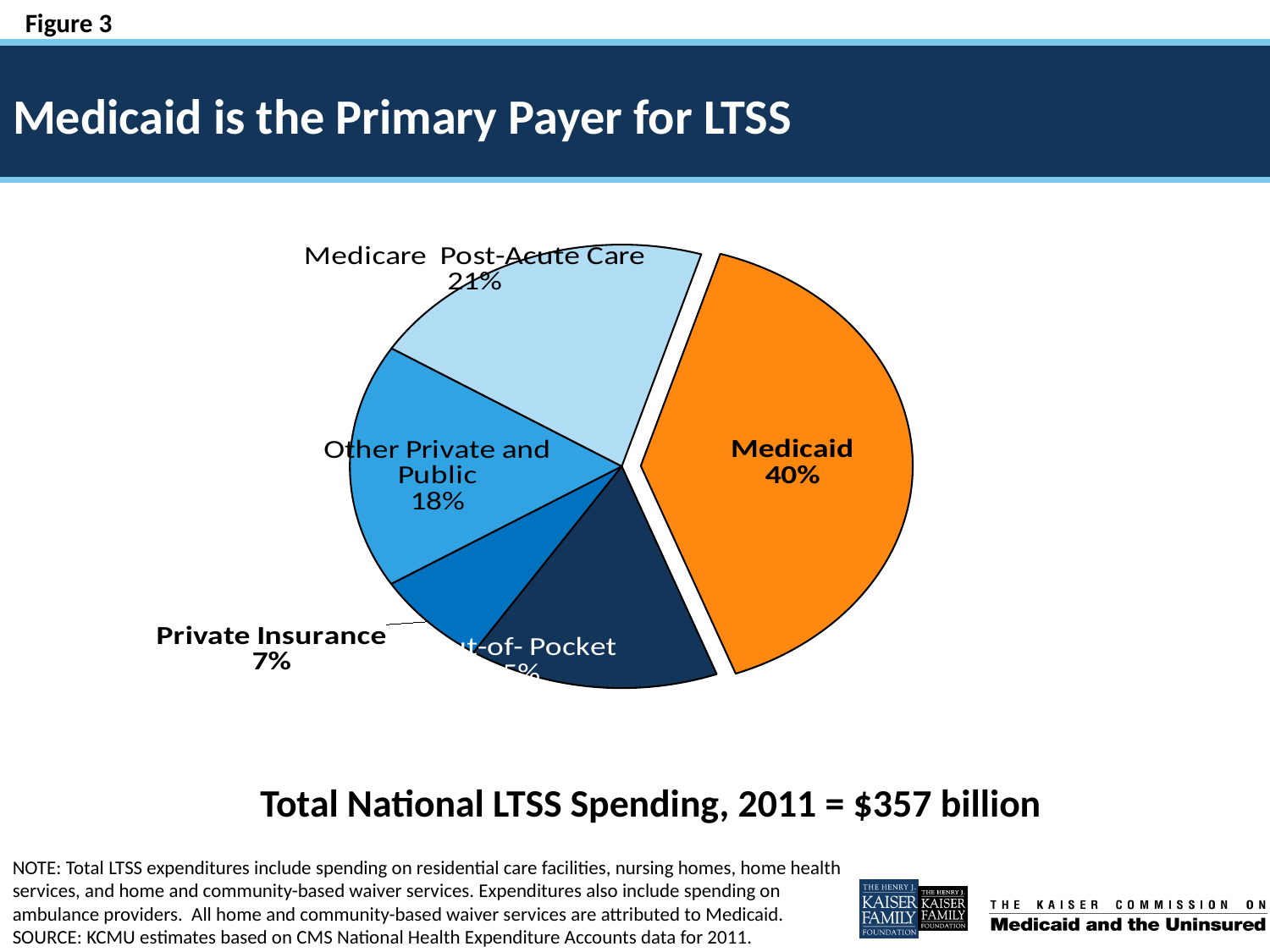
What percentage of LTSS spending is paid by Private Insurance? 7% How many slices does the pie chart have? 5 What share of LTSS spending comes from Other Private and Public sources? 18% How many percentage points larger is the Other Private and Public share than the Private Insurance share? 11 percentage points What share of total national LTSS spending does Medicaid account for? 40% What type of chart is shown on the slide? Pie chart What percentage of LTSS spending is attributed to Medicare Post-Acute Care? 21% Which payer has the smallest share of LTSS spending? Private Insurance How many percentage points larger is Medicaid's share than Medicare Post-Acute Care's share? 19 percentage points Which is larger: the share for Medicare Post-Acute Care or the share for Other Private and Public? Medicare Post-Acute Care Which payer has the largest share of LTSS spending? Medicaid What was total national LTSS spending in 2011 according to the slide? $357 billion